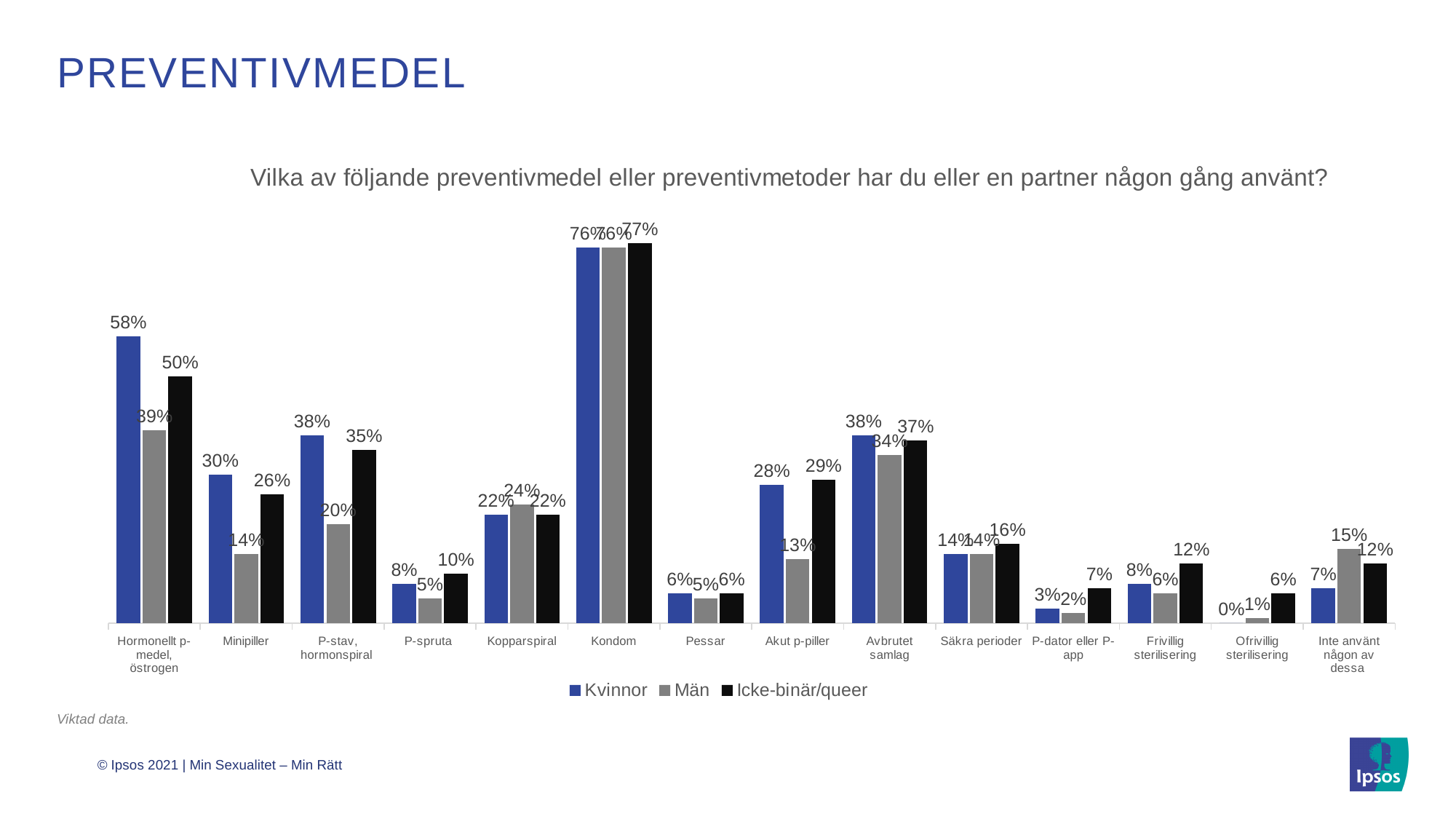
What is the difference between the Kvinnor and Män values for Hormonellt p-medel, östrogen? 19 percentage points What is the value for Män for Akut p-piller? 13% How many categories are shown on the x axis? 14 How many series does the legend list? 3 Which series is shown in black in the legend? Icke-binär/queer What kind of chart is shown on the slide? Bar chart What is the difference between the Icke-binär/queer and Kvinnor values for Frivillig sterilisering? 4 percentage points What is the value for Icke-binär/queer for P-dator eller P-app? 7% Which category has the highest value for Kvinnor? Kondom For Inte använt någon av dessa, which is larger: the value for Kvinnor or the value for Män? Män Which category has the lowest value for Kvinnor? Ofrivillig sterilisering What is the value for Kvinnor for Hormonellt p-medel, östrogen? 58%